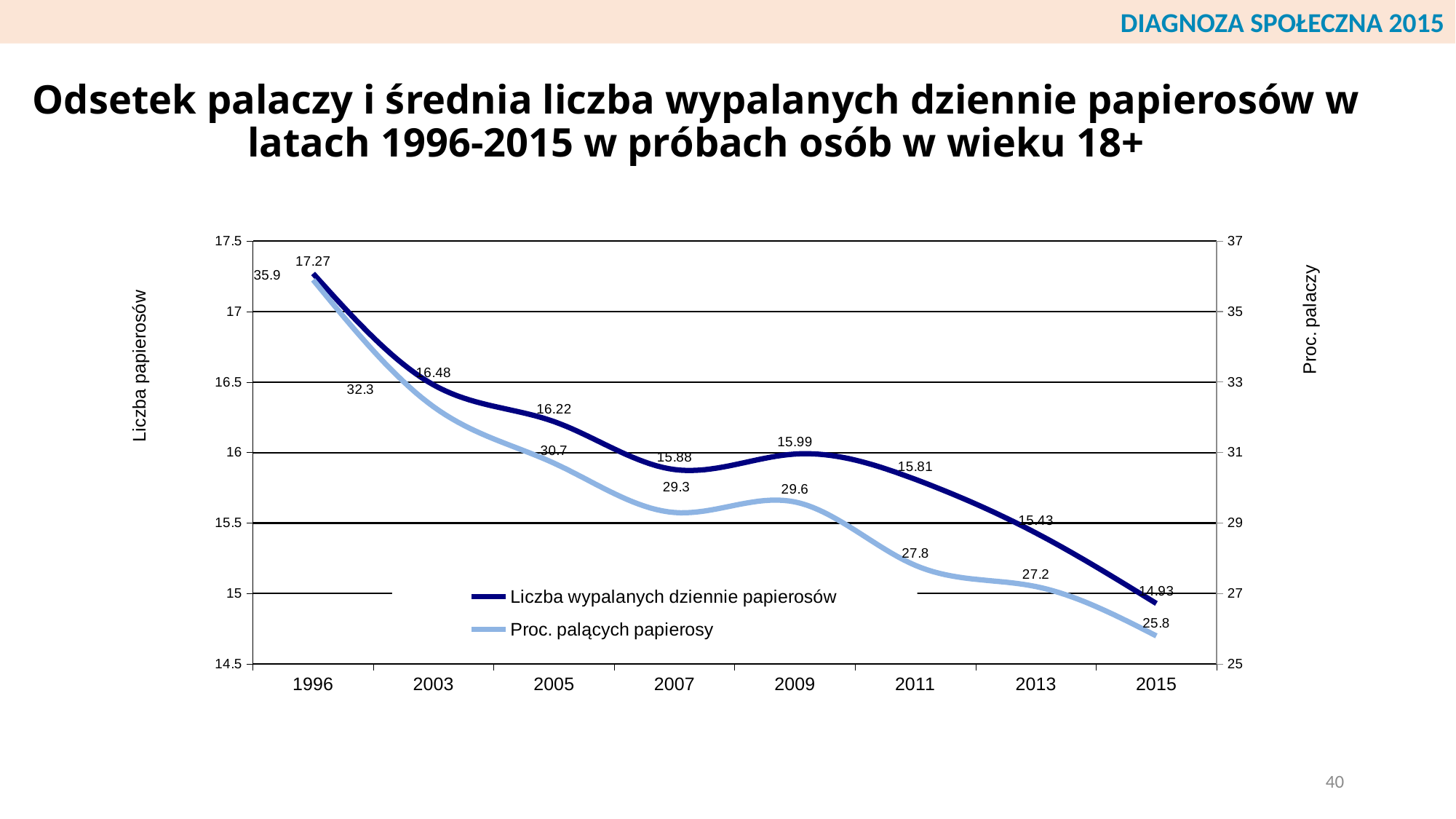
How many years are plotted on the x axis? 8 What is the label of the right-hand vertical axis? Proc. palaczy How many series does the legend list? 2 Overall, does 'Proc. palących papierosy' rise or fall from 1996 to 2015? fall Which is larger for 'Liczba wypalanych dziennie papierosów': the value in 2007 or the value in 2009? 2009 In which year is 'Proc. palących papierosy' highest? 1996 What is the value of 'Proc. palących papierosy' in 2015? 25.8 What type of chart is shown on the slide? line chart What is the value of 'Proc. palących papierosy' in 2009? 29.6 In which year is 'Liczba wypalanych dziennie papierosów' lowest? 2015 What is the difference between the 'Proc. palących papierosy' values for 1996 and 2015? 10.1 What is the value of 'Liczba wypalanych dziennie papierosów' in 1996? 17.27